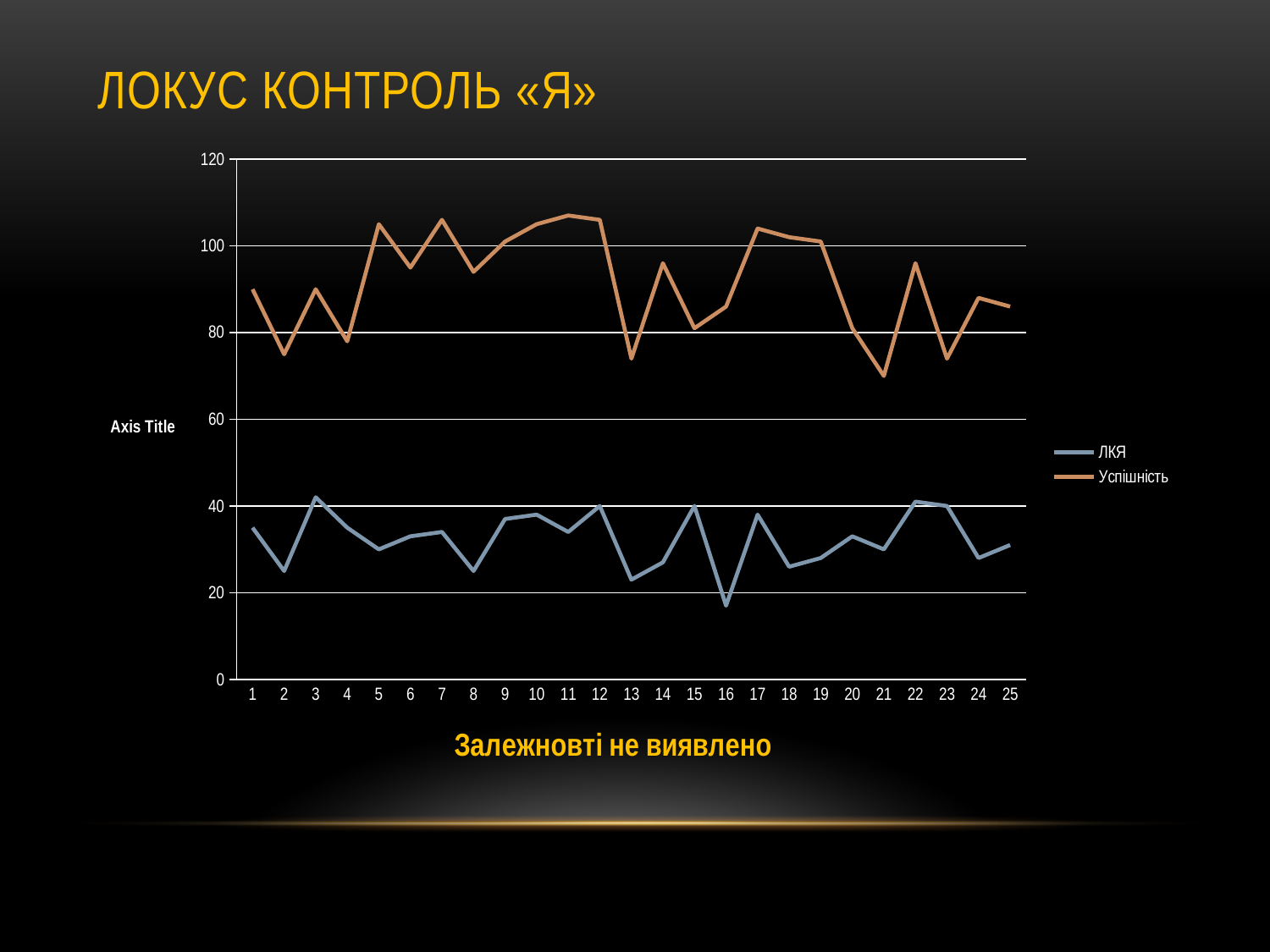
Is the value of Успішність at point 21 greater or less than 80? less What kind of chart is shown on the slide? line chart At which x-axis point does the Успішність series reach its lowest value? 21 Which series is plotted in orange according to the legend? Успішність Which is larger: the value of Успішність at point 5 or at point 2? point 5 Is the value of Успішність at point 11 greater or less than 100? greater At which x-axis point does the ЛКЯ series reach its lowest value? 16 Is the value of ЛКЯ at point 16 greater or less than 20? less How many series does the legend list? 2 What is the text of the vertical axis title? Axis Title How many points are plotted along the x axis for each series? 25